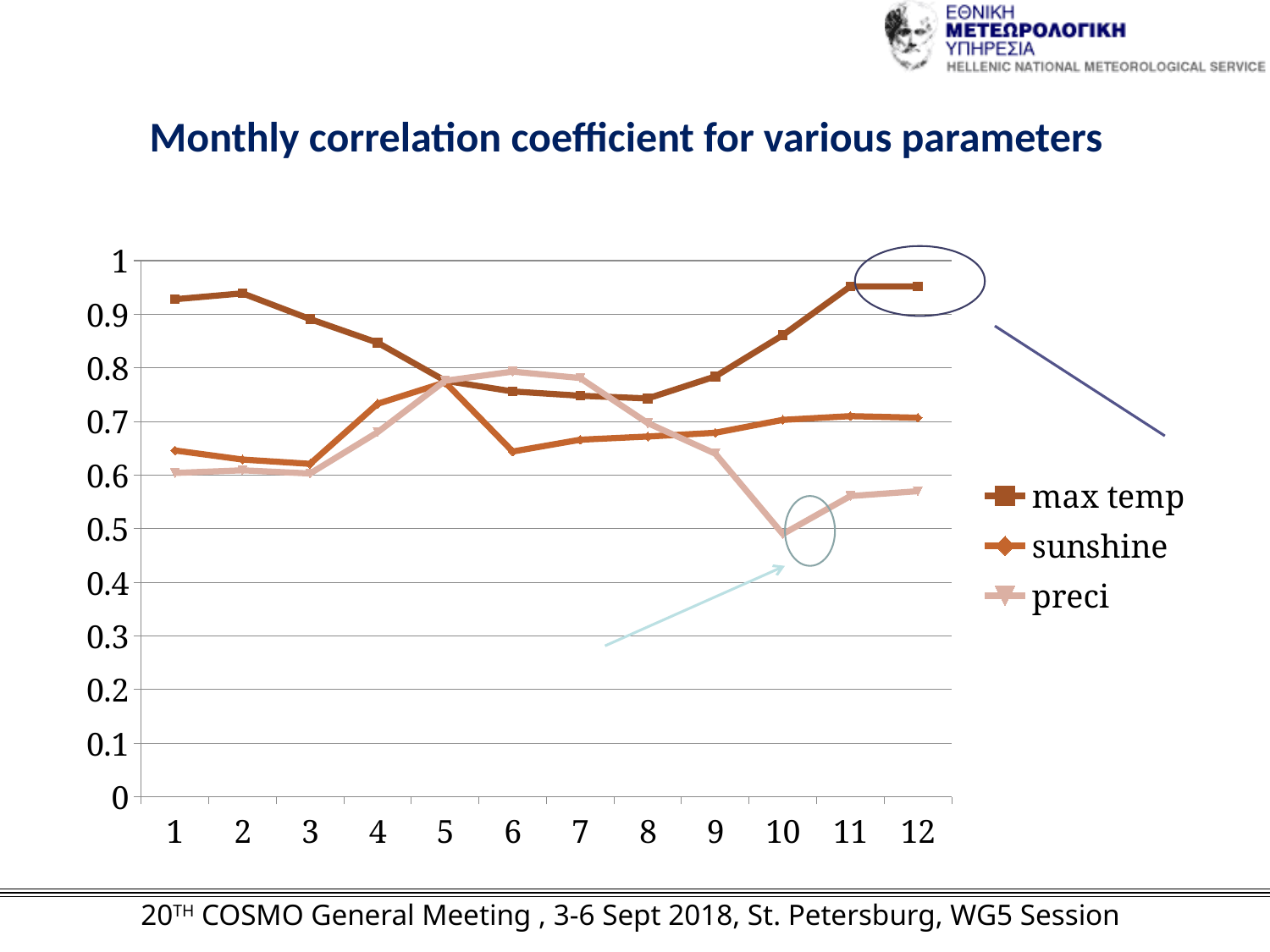
Is the preci value for month 10 greater or less than 0.6? less Is the max temp value for month 1 greater or less than 0.9? greater At month 1, which series has the larger value, max temp or sunshine? max temp What kind of chart is shown on the slide? line chart Is the max temp value for month 12 greater or less than 0.9? greater At month 10, which series has the lowest value? preci Does the max temp series rise or fall from month 8 to month 12? rise What is the title of the chart? Monthly correlation coefficient for various parameters How many series does the legend list? 3 In which month does the preci series reach its lowest value? 10 How many months are plotted along the x axis? 12